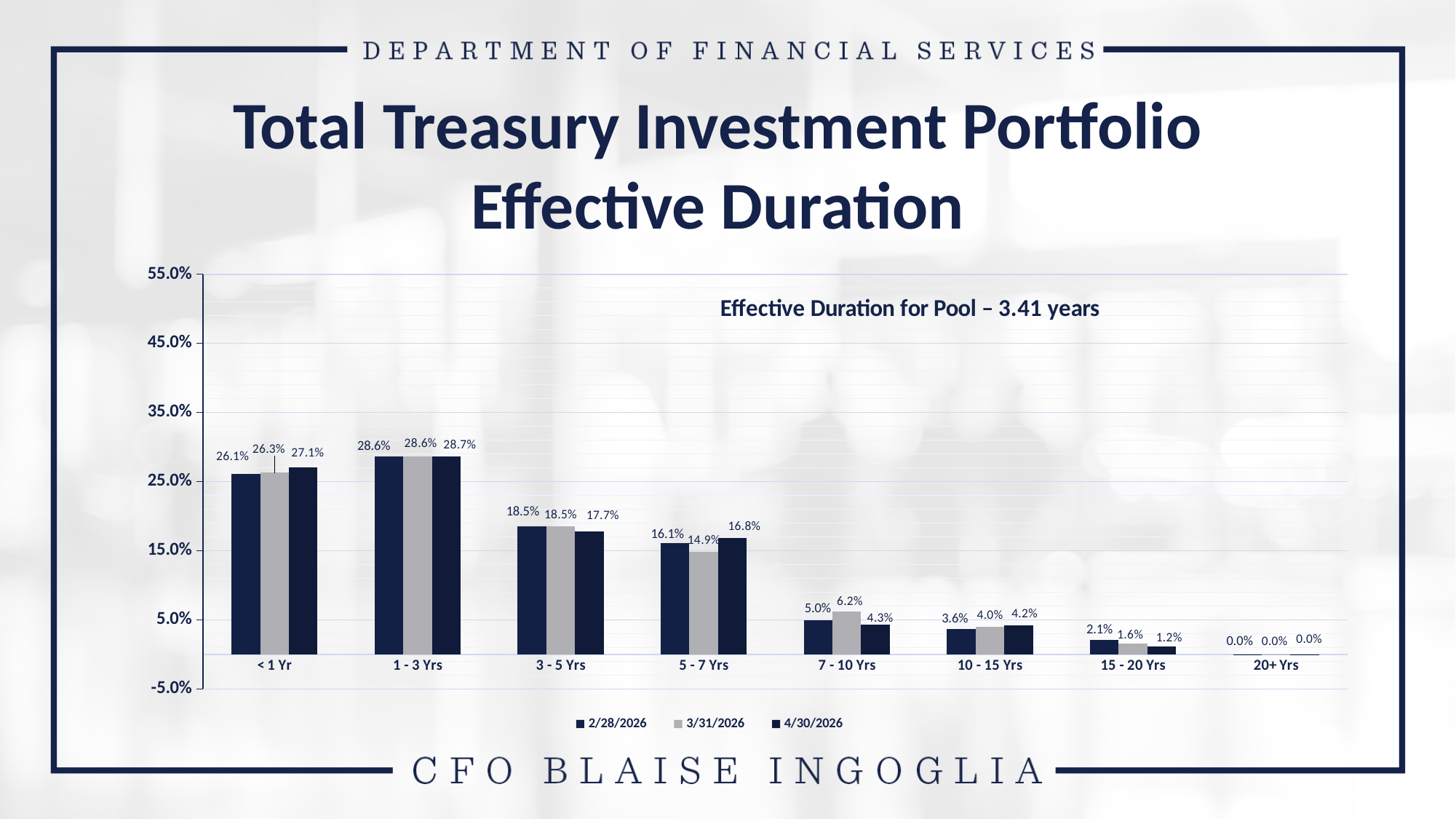
Which category has the lowest value in the 2/28/2026 series? 20+ Yrs What is the value for the 5 - 7 Yrs category in the 3/31/2026 series? 14.9% What kind of chart is shown on the slide? Bar chart What is the value for the 7 - 10 Yrs category in the 4/30/2026 series? 4.3% How many series does the legend list? 3 For the 7 - 10 Yrs category, which series has the larger value: 2/28/2026 or 3/31/2026? 3/31/2026 How many categories are shown on the x axis? 8 Is the 3/31/2026 value for the 3 - 5 Yrs category greater or less than 15.0%? greater What is the value for the < 1 Yr category in the 2/28/2026 series? 26.1% What effective duration for the pool is stated on the chart? 3.41 years Which category has the highest value in the 4/30/2026 series? 1 - 3 Yrs What is the difference between the 2/28/2026 and 4/30/2026 values for the 15 - 20 Yrs category? 0.9%